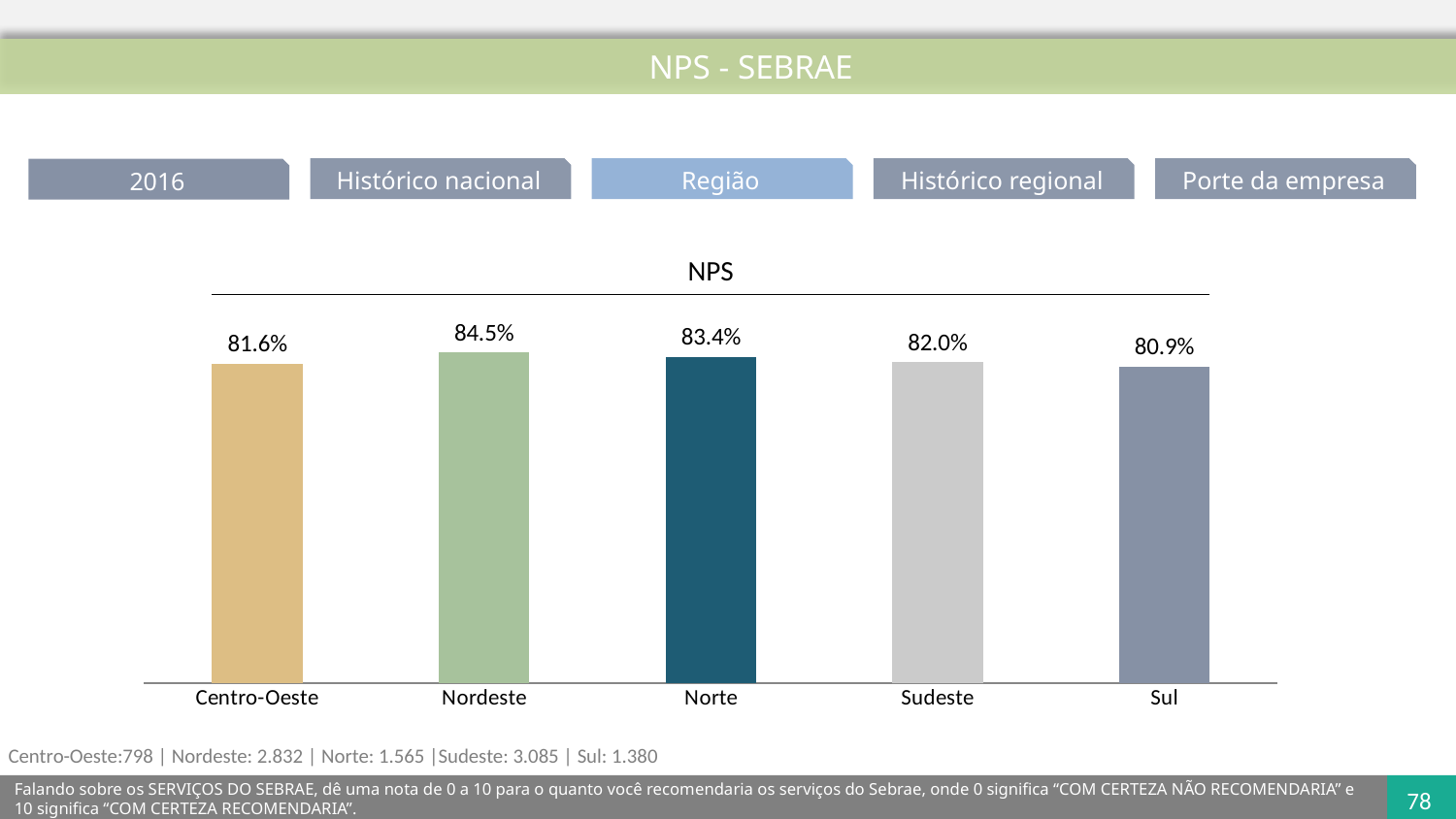
What is the NPS value for Sul? 80.9% Which region has the highest NPS? Nordeste What is the NPS value for Centro-Oeste? 81.6% What is the NPS value for Nordeste? 84.5% How many regions are shown in the chart? 5 What is the NPS value for Sudeste? 82.0% What is the title of the chart? NPS What type of chart is shown on the slide? Bar chart Which has a higher NPS, Norte or Sudeste? Norte What is the difference between the NPS of Nordeste and Sul? 3.6 percentage points Which region has the lowest NPS? Sul What is the difference between the NPS of Norte and Centro-Oeste? 1.8 percentage points